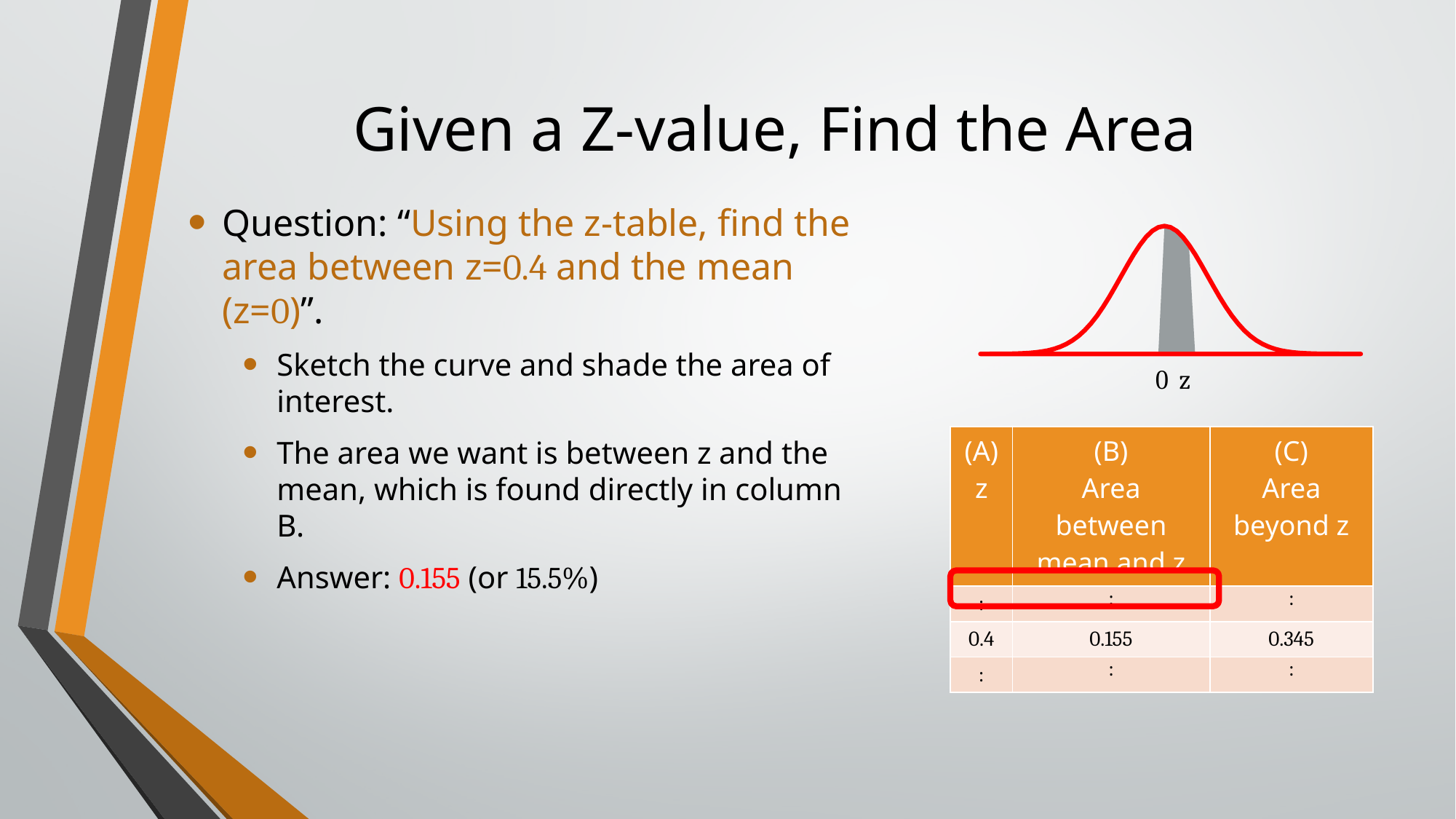
What two labels appear beneath the horizontal axis of the curve chart? 0 and z In the table below the curve, what is the difference between the area beyond z and the area between mean and z for z = 0.4? 0.190 In the table below the curve, what is the sum of the area between mean and z and the area beyond z for z = 0.4? 0.500 What colour is the curve drawn in the chart at the top right? Red In the table below the curve, what is the value in column (B) 'Area between mean and z' for z = 0.4? 0.155 In the table below the curve, which is larger for z = 0.4: the area between mean and z, or the area beyond z? Area beyond z In the table below the curve, what is the value in column (C) 'Area beyond z' for z = 0.4? 0.345 What kind of chart is shown at the top right of the slide? An area chart (a bell-shaped normal curve with a shaded region)